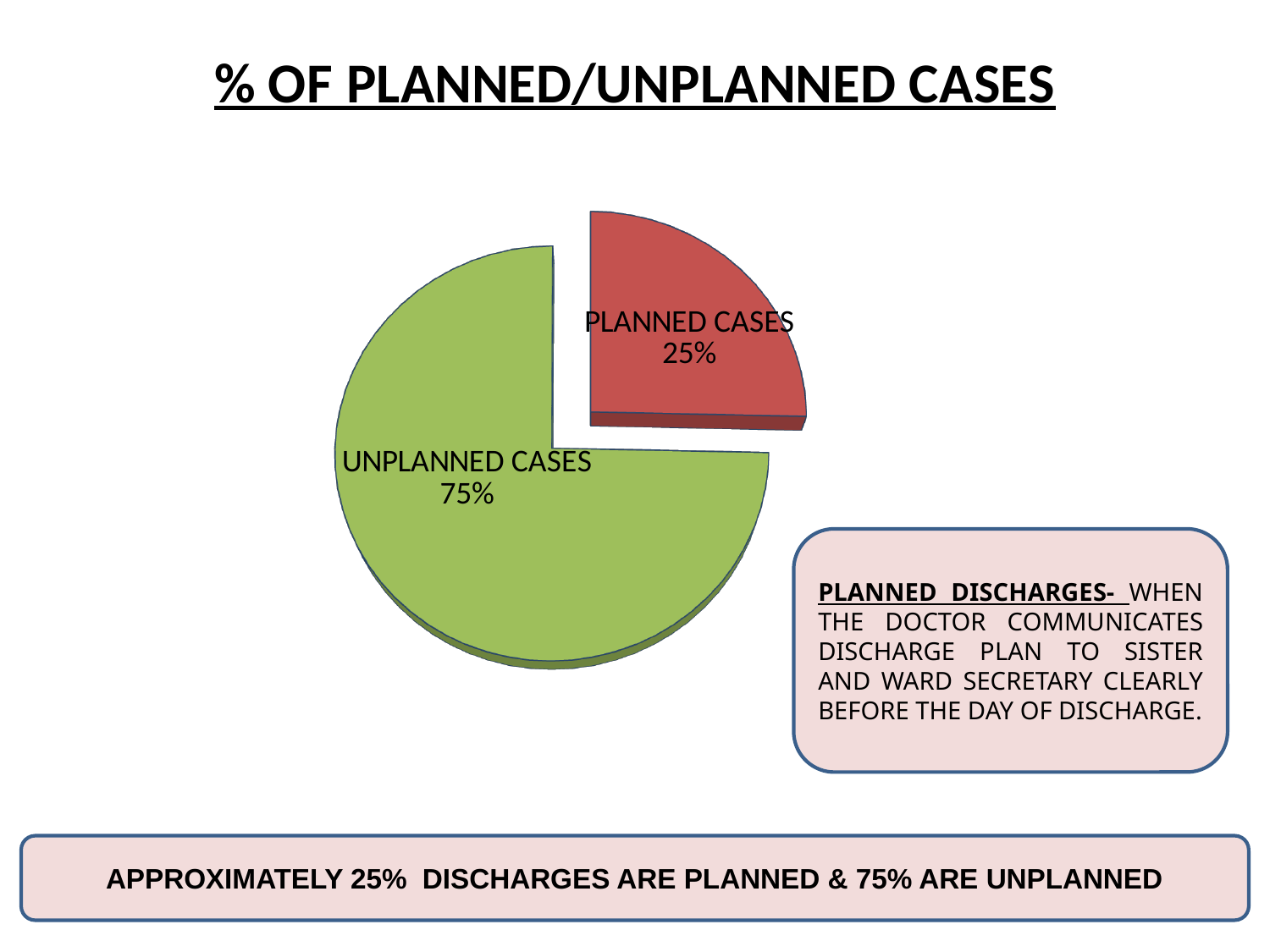
What percentage of cases are unplanned cases? 75% What kind of chart is shown on the slide? Pie chart What share of the pie do planned cases represent? 25% How many slices does the pie chart have? 2 Which is larger, the share of planned cases or the share of unplanned cases? UNPLANNED CASES Which slice of the pie is the largest? UNPLANNED CASES What is the difference in percentage points between unplanned cases and planned cases? 50 What percentage of cases are planned cases? 25% Which slice of the pie is the smallest? PLANNED CASES What colour is the slice for planned cases? Red What is the title of the chart on the slide? % OF PLANNED/UNPLANNED CASES